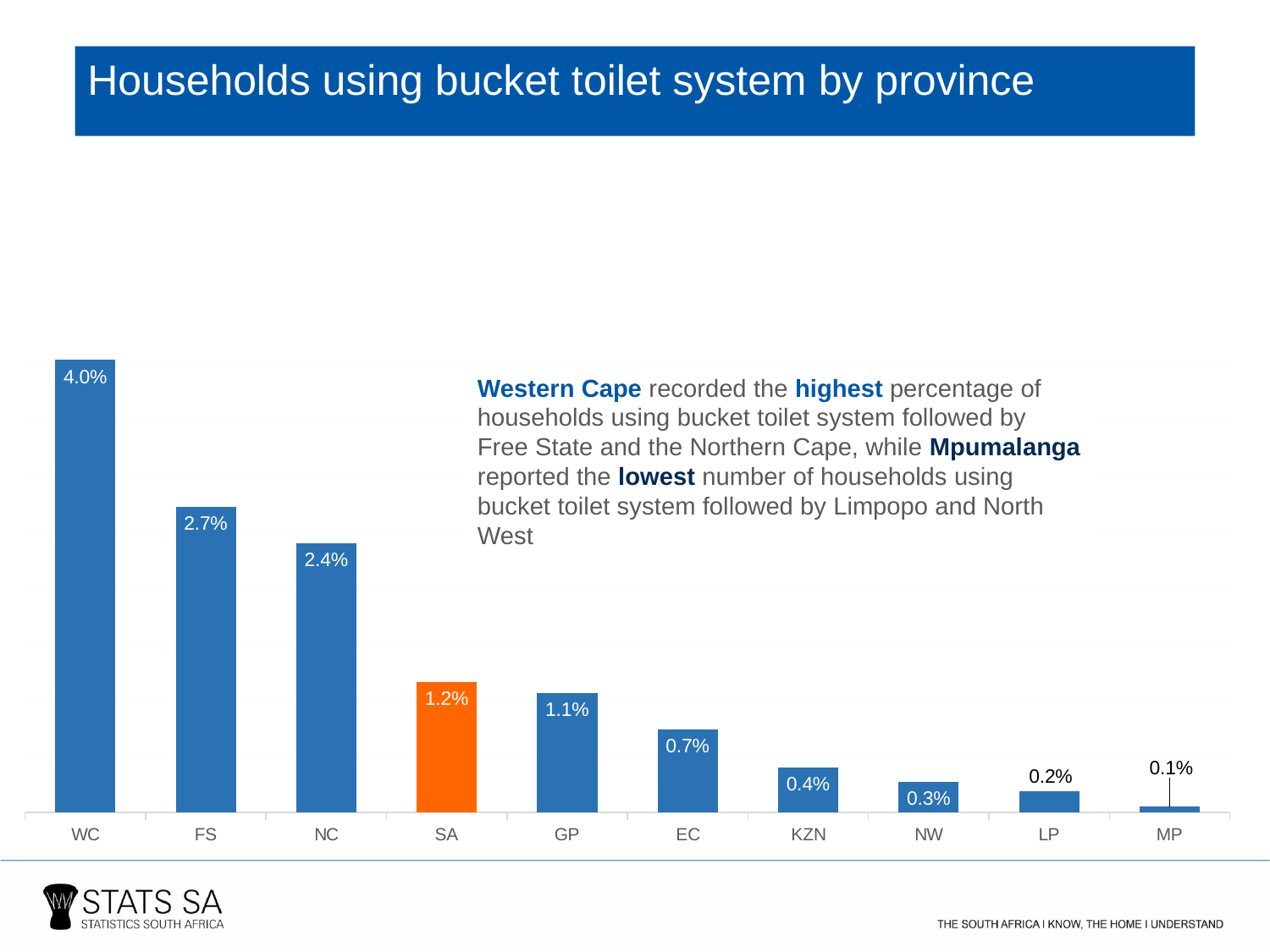
Do the values rise or fall from left to right along the x axis? Fall Which bar is coloured orange rather than blue? SA What is the value for SA? 1.2% Which is larger, the value for GP or the value for EC? GP What kind of chart is this? Bar chart What is the difference between the values for WC and SA? 2.8% What is the value for WC? 4.0% Which province has the highest value? WC Which category has the lowest value? MP What is the value for KZN? 0.4% How many categories are shown on the x axis? 10 What is the difference between the values for FS and NC? 0.3%